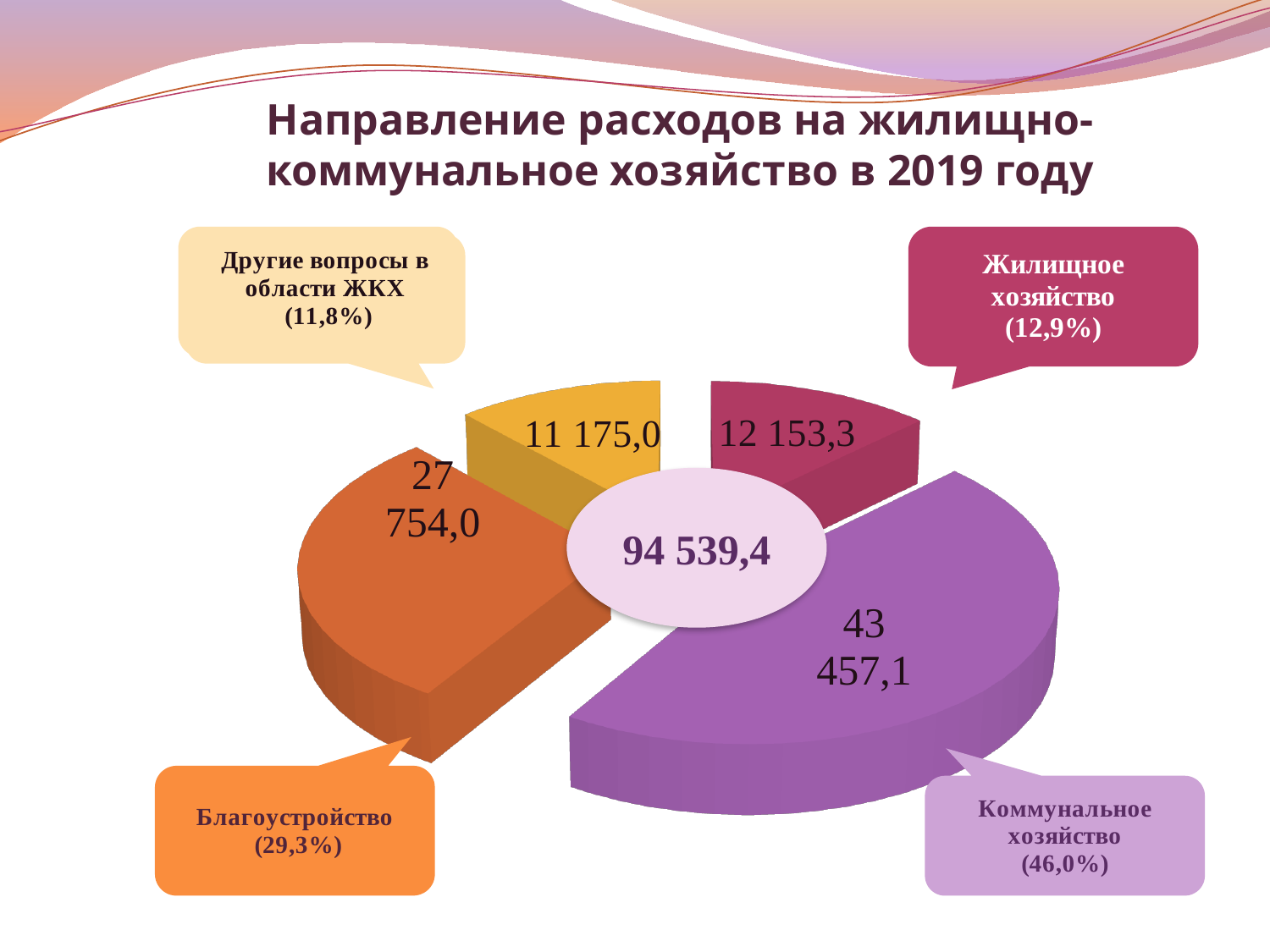
What share of the pie does Благоустройство represent? 29,3% What is the value for Благоустройство? 27 754,0 What is the value for Другие вопросы в области ЖКХ? 11 175,0 What is the value for Коммунальное хозяйство? 43 457,1 Which category has the smallest slice of the pie? Другие вопросы в области ЖКХ What is the value for Жилищное хозяйство? 12 153,3 What is the difference between the values for Коммунальное хозяйство and Благоустройство? 15 703,1 How many slices does the pie chart have? 4 What share of the pie does Коммунальное хозяйство represent? 46,0% Which is larger, the value for Жилищное хозяйство or the value for Другие вопросы в области ЖКХ? Жилищное хозяйство What kind of chart is shown on the slide? pie chart Which category has the largest slice of the pie? Коммунальное хозяйство